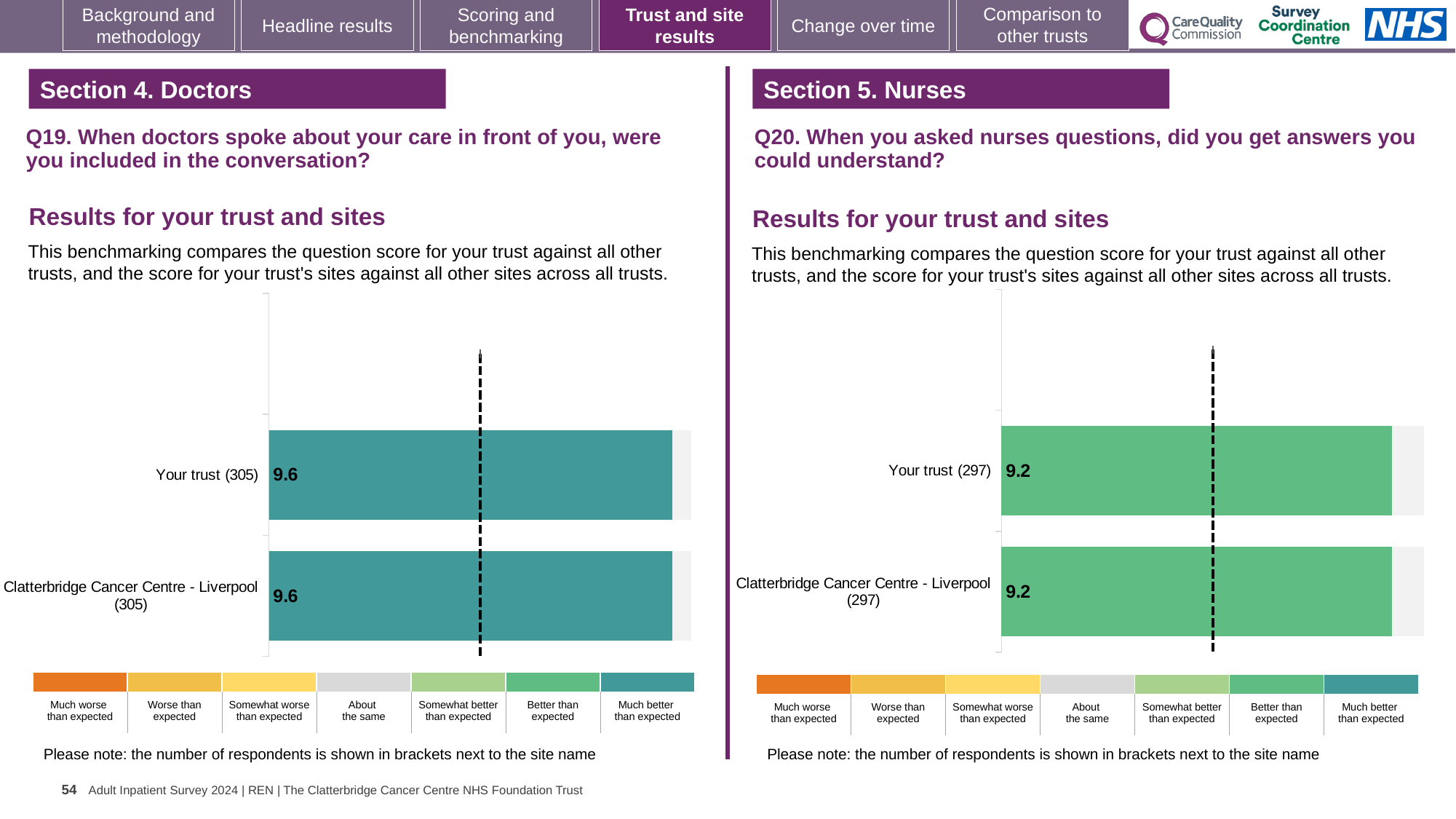
On the Q19 chart (Section 4. Doctors), how many bars are plotted? 2 On the Q19 chart (Section 4. Doctors), what is the score for Your trust? 9.6 On the Q19 chart (Section 4. Doctors), what is the score for Clatterbridge Cancer Centre - Liverpool? 9.6 What kind of chart is used on the Q19 chart (Section 4. Doctors)? Bar chart On the Q20 chart (Section 5. Nurses), what is the score for Clatterbridge Cancer Centre - Liverpool? 9.2 On the Q20 chart (Section 5. Nurses), how many bars are plotted? 2 On the Q20 chart (Section 5. Nurses), which benchmark category does the bar colour correspond to in the legend? Better than expected On the Q19 chart (Section 4. Doctors), how many respondents are shown in brackets for Your trust? 305 On the Q20 chart (Section 5. Nurses), what is the difference between the score for Your trust and the score for Clatterbridge Cancer Centre - Liverpool? 0 On the Q20 chart (Section 5. Nurses), what is the score for Your trust? 9.2 On the Q19 chart (Section 4. Doctors), what is the difference between the score for Your trust and the score for Clatterbridge Cancer Centre - Liverpool? 0 On the Q20 chart (Section 5. Nurses), how many respondents are shown in brackets for Clatterbridge Cancer Centre - Liverpool? 297